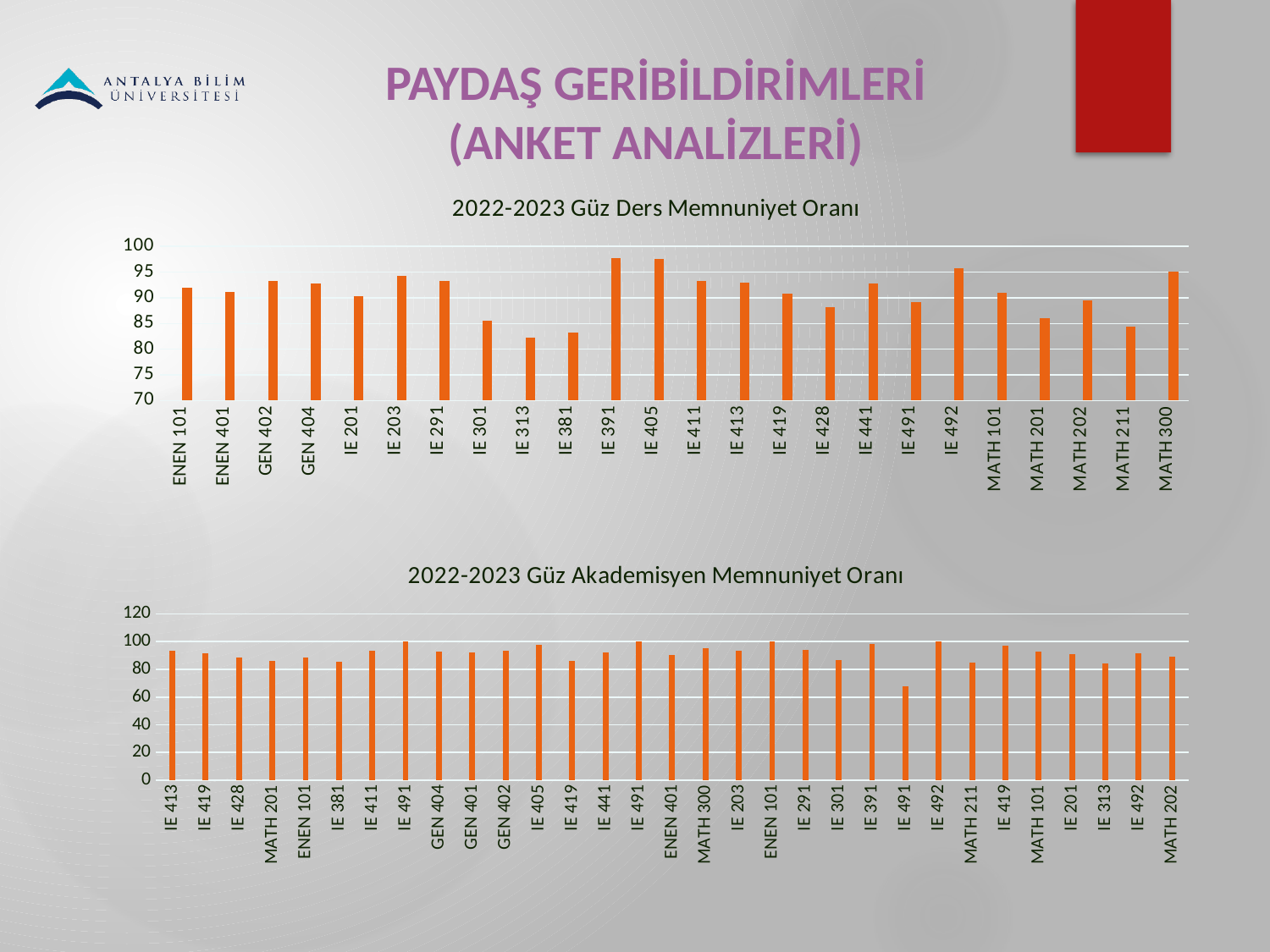
In the top chart '2022-2023 Güz Ders Memnuniyet Oranı', is the value for ENEN 101 greater or less than 90? greater What is the title of the bottom chart on the slide? 2022-2023 Güz Akademisyen Memnuniyet Oranı In the top chart '2022-2023 Güz Ders Memnuniyet Oranı', which has the larger value, GEN 402 or MATH 211? GEN 402 In the bottom chart '2022-2023 Güz Akademisyen Memnuniyet Oranı', is the value for IE 413 greater or less than 80? greater In the bottom chart '2022-2023 Güz Akademisyen Memnuniyet Oranı', is the lowest bar (IE 491) greater or less than 80? less In the top chart '2022-2023 Güz Ders Memnuniyet Oranı', which has the larger value, ENEN 101 or IE 313? ENEN 101 In the top chart '2022-2023 Güz Ders Memnuniyet Oranı', how many courses are shown on the x axis? 24 What kind of chart is the top chart, '2022-2023 Güz Ders Memnuniyet Oranı'? Bar chart What is the highest value shown on the y axis of the bottom chart '2022-2023 Güz Akademisyen Memnuniyet Oranı'? 120 In the bottom chart '2022-2023 Güz Akademisyen Memnuniyet Oranı', which course has the lowest bar? IE 491